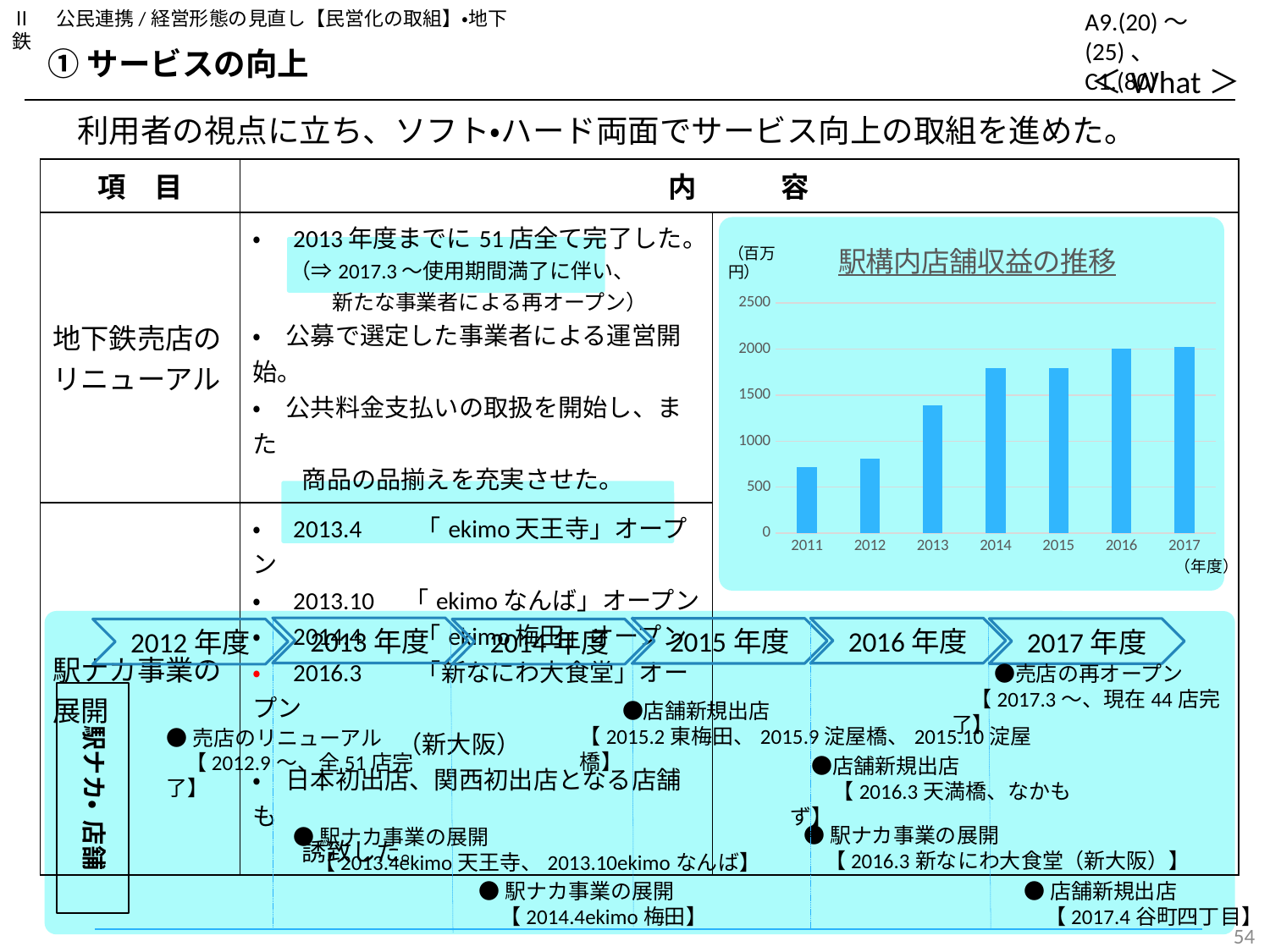
Do the values generally rise or fall from 2011 to 2017? rise Is the value for 2013 greater or less than 1000? greater What unit is shown on the vertical axis of the chart? 百万円 Is the value for 2013 greater or less than 1500? less Is the value for 2014 greater or less than 1500? greater What is the title of the chart? 駅構内店舗収益の推移 How many years (bars) are plotted in the chart? 7 What kind of chart is shown on the slide? bar chart Which year has the lowest value in the chart? 2011 Which is larger, the value for 2012 or the value for 2013? 2013